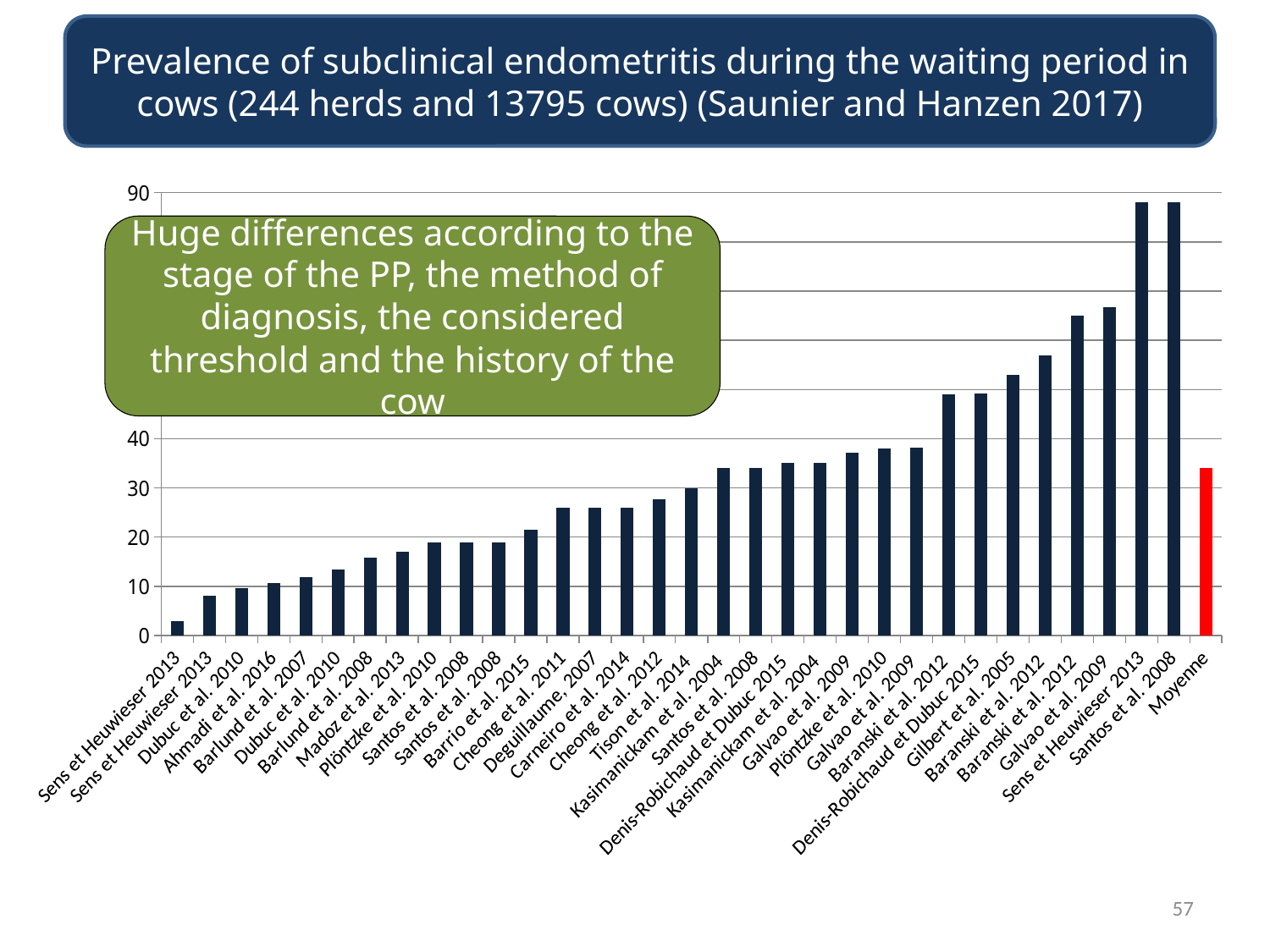
Which category has the lowest bar in the chart? Sens et Heuwieser 2013 Which is larger, the value for Cheong et al. 2011 or the value for Barrio et al. 2015? Cheong et al. 2011 What kind of chart is shown on the slide? bar chart Is the value for Moyenne greater or less than 30? greater What is the highest value shown on the vertical axis? 90 Is the value for Gilbert et al. 2005 greater or less than 40? greater Is the value for Moyenne greater or less than 40? less Which bar is coloured red rather than dark blue? Moyenne Which is larger, the value for Gilbert et al. 2005 or the value for Moyenne? Gilbert et al. 2005 Do the bar values generally rise or fall from left to right along the x axis? rise